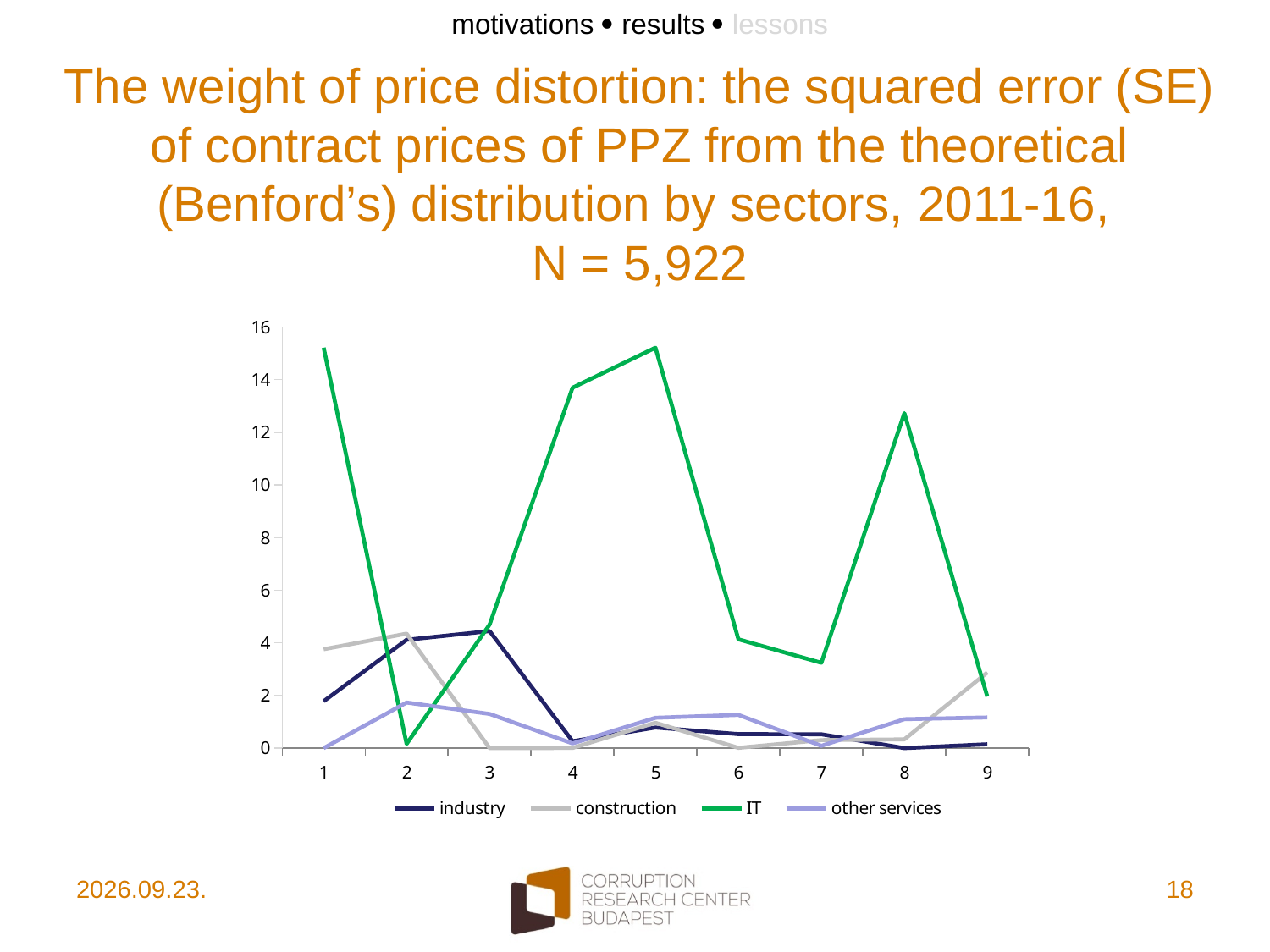
Does the IT series rise or fall from point 6 to point 7? fall Is the value for IT at point 8 greater or less than 12? greater How many points are there along the x axis? 9 At point 9, which is larger: construction or industry? construction Is the value for industry at point 1 greater or less than 4? less Is the value for IT at point 2 greater or less than 2? less At which point on the x axis does the IT series reach its lowest value? 2 What colour is the IT line in the legend? green How many series does the legend list? 4 What kind of chart is shown on the slide? line chart Which series has the highest value at point 5? IT